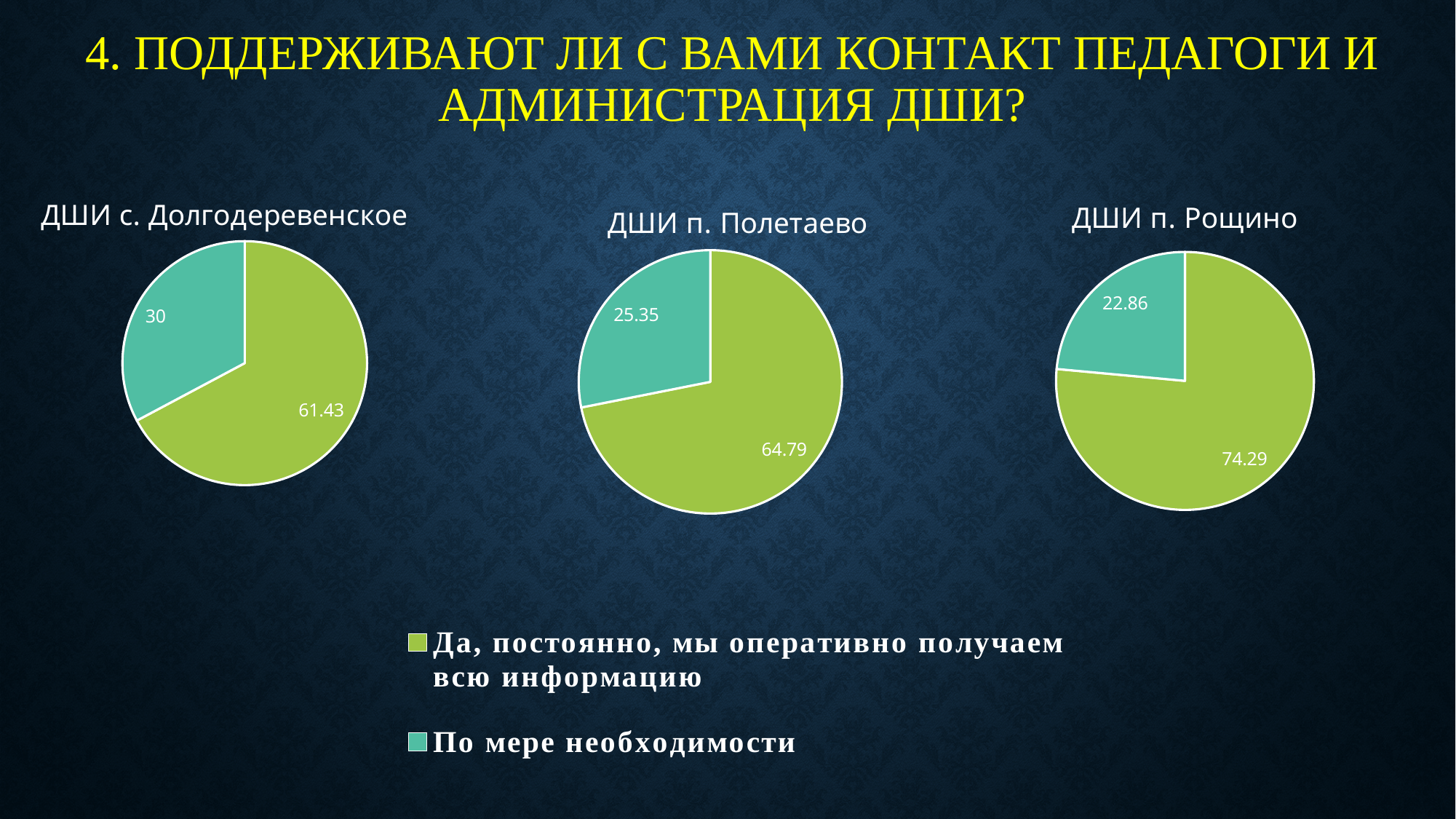
How many entries does the legend list? 2 In the 'ДШИ с. Долгодеревенское' chart, what is the difference between the two labelled values? 31.43 What type of chart is used for 'ДШИ п. Полетаево'? Pie chart In the 'ДШИ п. Рощино' chart, which category has the largest slice? Да, постоянно, мы оперативно получаем всю информацию In the 'ДШИ с. Долгодеревенское' chart, what is the value for 'По мере необходимости'? 30 In the 'ДШИ п. Полетаево' chart, what is the value for 'Да, постоянно, мы оперативно получаем всю информацию'? 64.79 Which is larger: the 'Да, постоянно' value in the 'ДШИ п. Рощино' chart or in the 'ДШИ п. Полетаево' chart? ДШИ п. Рощино In the 'ДШИ п. Рощино' chart, what is the value for 'По мере необходимости'? 22.86 In the 'ДШИ п. Полетаево' chart, which category has the smallest slice? По мере необходимости In the 'ДШИ п. Полетаево' chart, what is the value for 'По мере необходимости'? 25.35 In the 'ДШИ п. Рощино' chart, what is the value for 'Да, постоянно, мы оперативно получаем всю информацию'? 74.29 In the 'ДШИ с. Долгодеревенское' chart, what is the value for 'Да, постоянно, мы оперативно получаем всю информацию'? 61.43